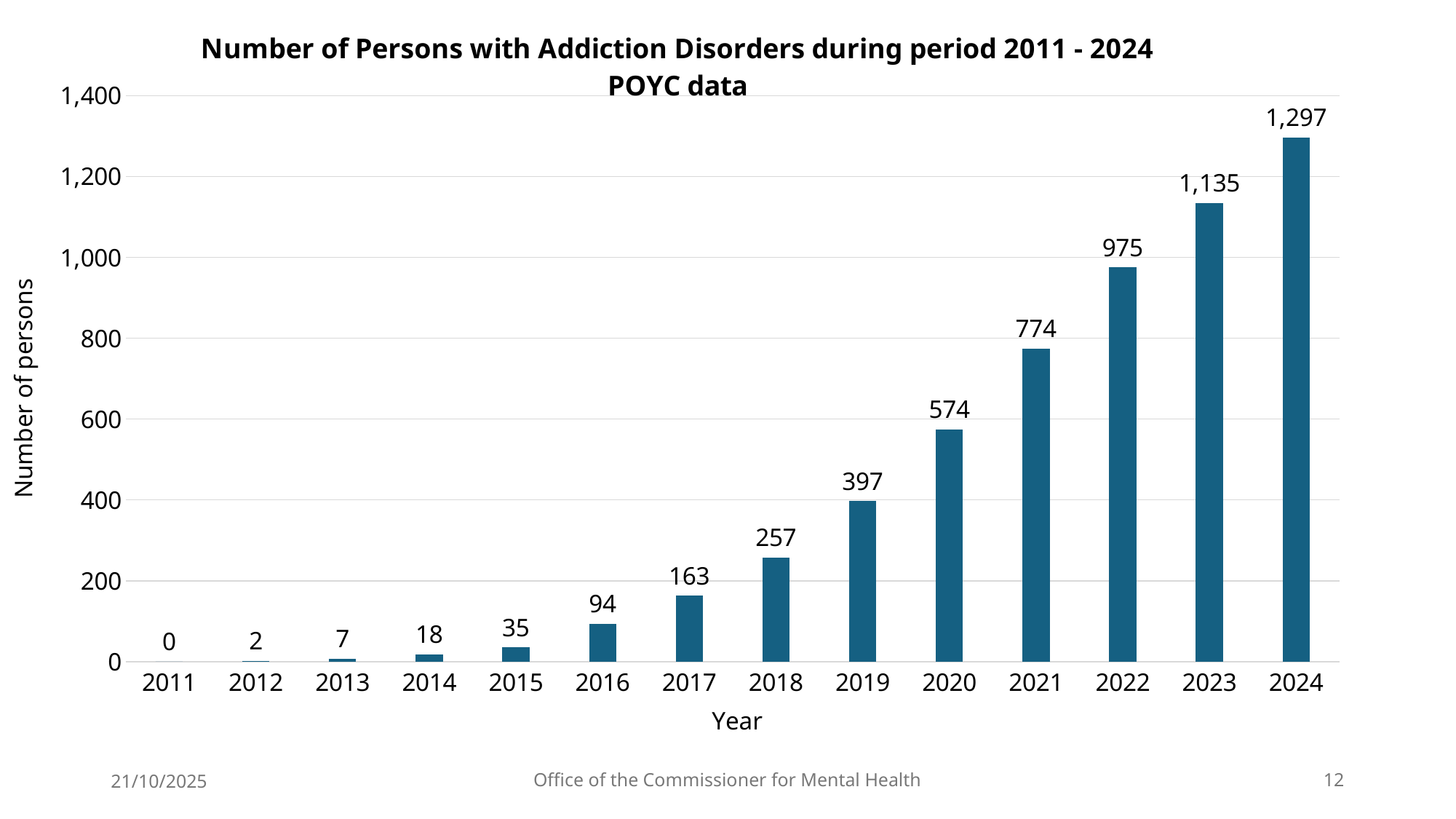
Which year has more persons with addiction disorders, 2018 or 2022? 2022 What is the difference between the number of persons in 2021 and in 2019? 377 What kind of chart is shown on the slide? Bar chart What is the number of persons with addiction disorders in 2016? 94 How many years are shown on the x axis of the chart? 14 What is the number of persons with addiction disorders in 2023? 1,135 What is the number of persons with addiction disorders in 2020? 574 Is the value for 2021 greater or less than 600? greater Which year has the lowest number of persons with addiction disorders? 2011 Do the values rise or fall from 2011 to 2024? Rise What is the difference between the number of persons in 2024 and in 2023? 162 Which year has the highest number of persons with addiction disorders? 2024